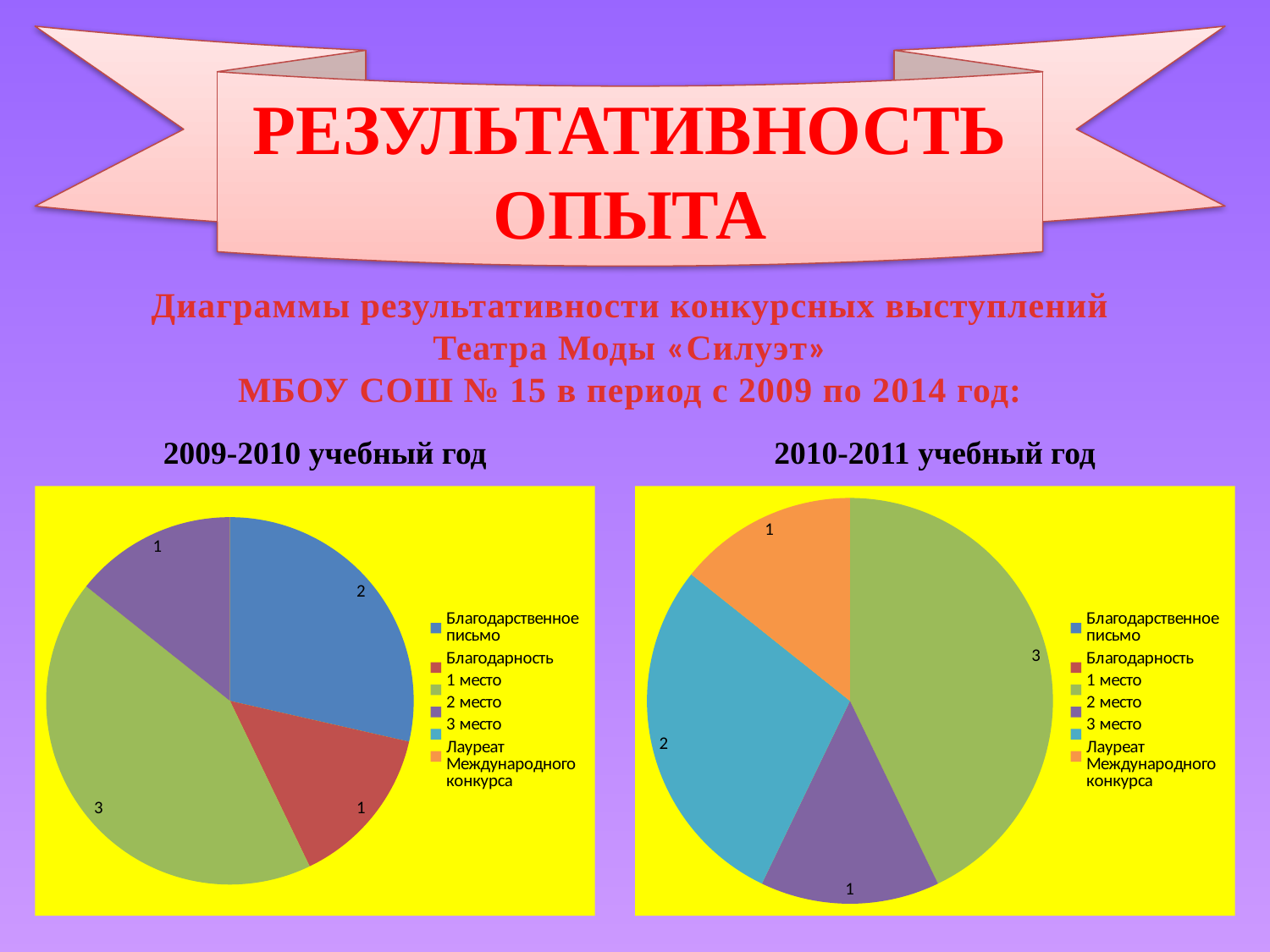
In the 2010-2011 учебный год chart, which is larger, 3 место or 2 место? 3 место In the 2009-2010 учебный год chart, which category has the largest slice? 1 место In the 2010-2011 учебный год chart, which category has the largest slice? 1 место In the 2010-2011 учебный год chart, what is the value for Лауреат Международного конкурса? 1 How many entries does the legend of the 2010-2011 учебный год chart list? 6 In the 2009-2010 учебный год chart, what is the difference between the values for 1 место and Благодарность? 2 In the 2009-2010 учебный год chart, what is the value for 1 место? 3 In the 2009-2010 учебный год chart, what is the total of all the slice values? 7 What kind of chart is the 2009-2010 учебный год chart? pie chart How many slices are plotted in the 2009-2010 учебный год pie chart? 4 In the 2010-2011 учебный год chart, what is the value for 3 место? 2 In the 2009-2010 учебный год chart, what is the value for Благодарственное письмо? 2